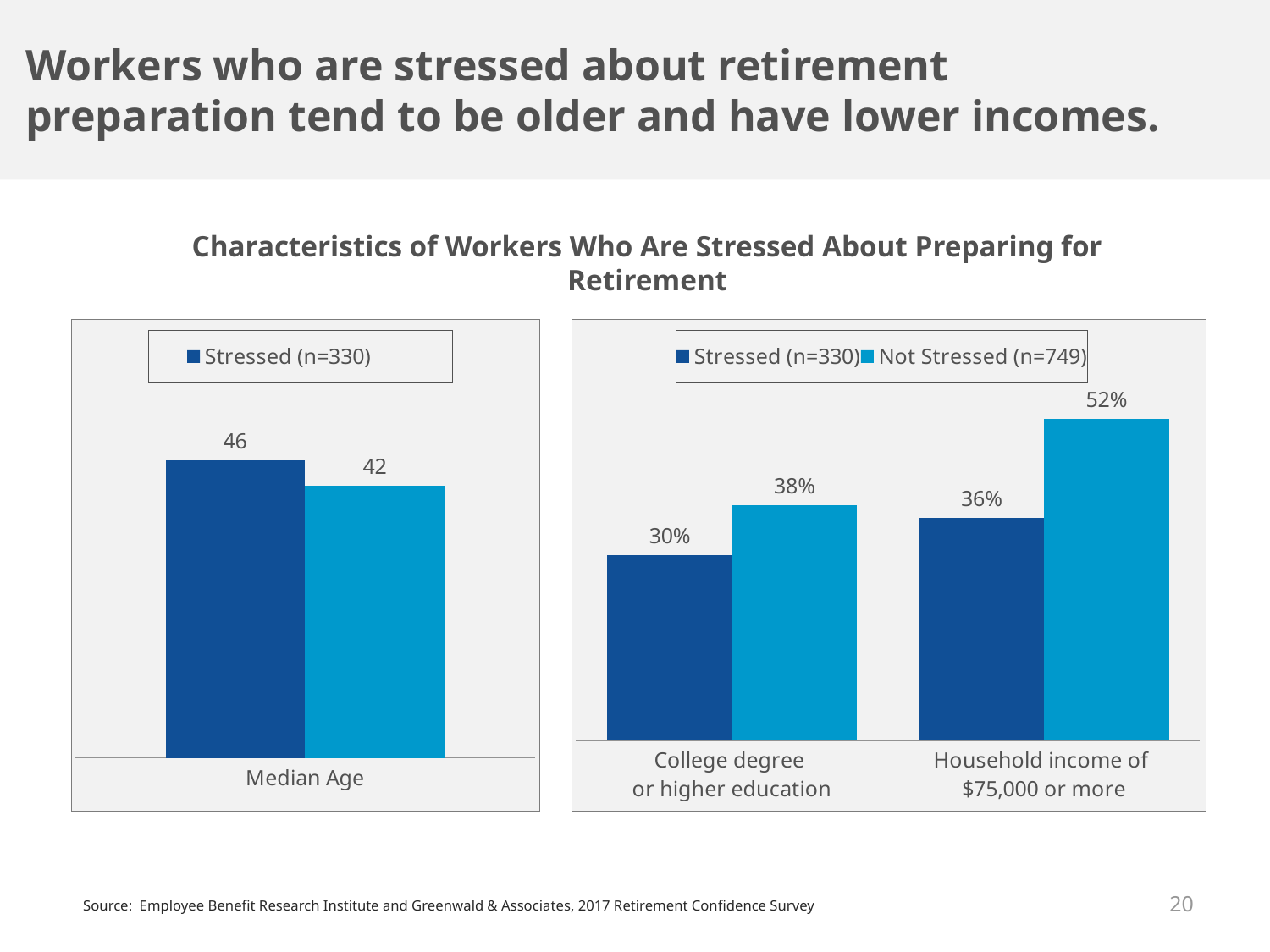
In the left chart (Median Age), what value is shown on the light blue bar? 42 In the right chart, what percentage of Not Stressed (n=749) workers have a college degree or higher education? 38% In the right chart, what percentage of Stressed (n=330) workers have a college degree or higher education? 30% What kind of chart is the right chart? Bar chart How many categories are shown on the x axis of the right chart? 2 In the right chart, what is the difference between Not Stressed and Stressed for household income of $75,000 or more? 16% How many series does the legend of the right chart list? 2 In the right chart, what percentage of Not Stressed (n=749) workers have a household income of $75,000 or more? 52% In the left chart (Median Age), what is the median age for the Stressed (n=330) series? 46 In the left chart (Median Age), what is the difference between the two bars' values? 4 In the right chart, which is larger for college degree or higher education: Stressed or Not Stressed? Not Stressed In the right chart, which bar is the highest? Not Stressed (n=749), Household income of $75,000 or more